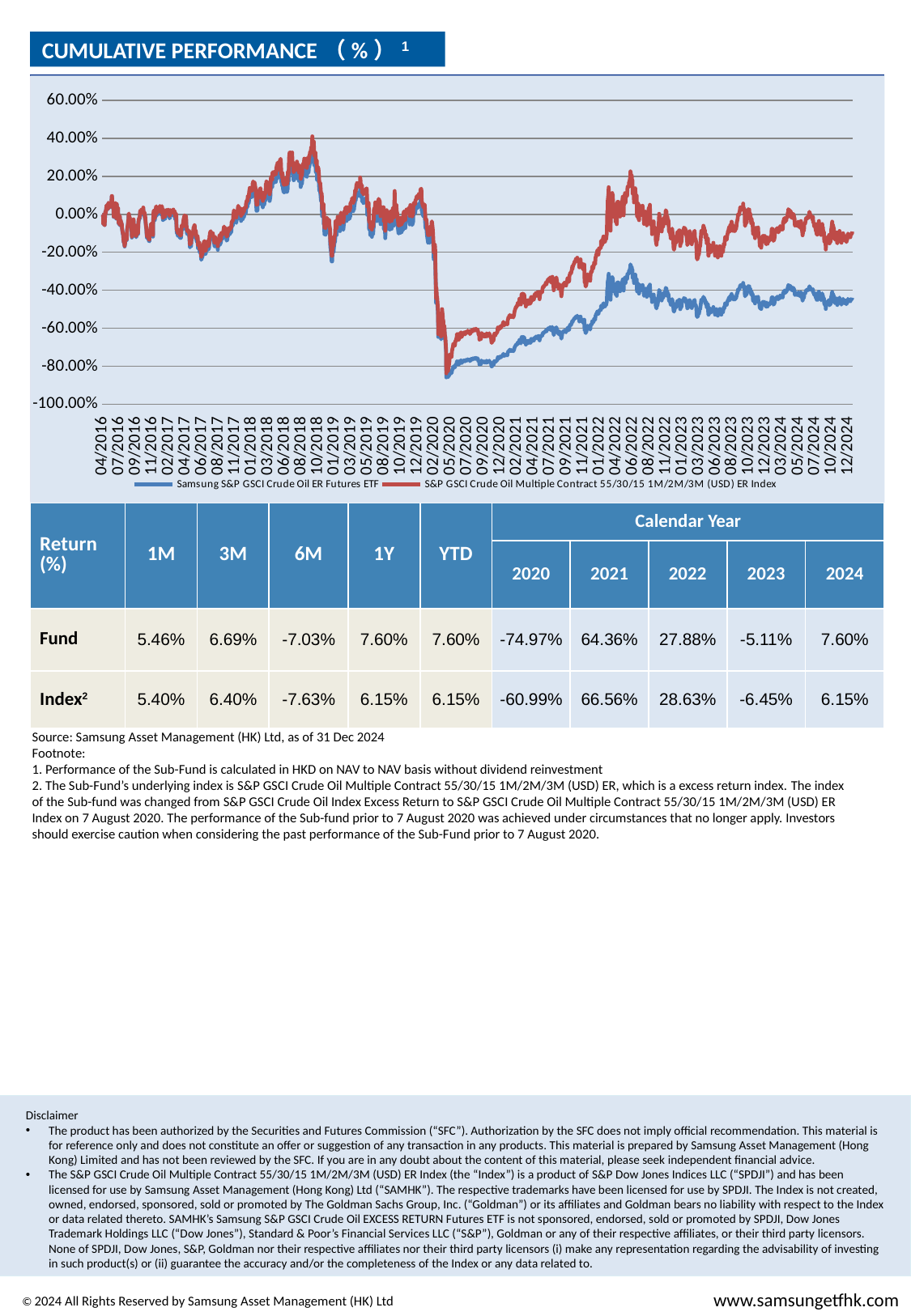
Which series is drawn in blue on the chart? Samsung S&P GSCI Crude Oil ER Futures ETF Does the S&P GSCI Crude Oil Multiple Contract 55/30/15 1M/2M/3M (USD) ER Index line rise or fall between 10/2018 and 12/2018? fall Does the Samsung S&P GSCI Crude Oil ER Futures ETF line rise or fall between 04/2020 and 06/2022? rise Is the value of the S&P GSCI Crude Oil Multiple Contract 55/30/15 1M/2M/3M (USD) ER Index at 12/2024 greater or less than -20.00%? greater What kind of chart is shown on the slide? line chart At 12/2024, which series is higher on the chart: the Samsung S&P GSCI Crude Oil ER Futures ETF or the S&P GSCI Crude Oil Multiple Contract 55/30/15 1M/2M/3M (USD) ER Index? S&P GSCI Crude Oil Multiple Contract 55/30/15 1M/2M/3M (USD) ER Index Is the value of the Samsung S&P GSCI Crude Oil ER Futures ETF at 12/2024 greater or less than -20.00%? less Is the lowest value of the Samsung S&P GSCI Crude Oil ER Futures ETF around 04/2020 greater or less than -60.00%? less How many series does the chart's legend list? 2 What is the title of the chart? CUMULATIVE PERFORMANCE (%)